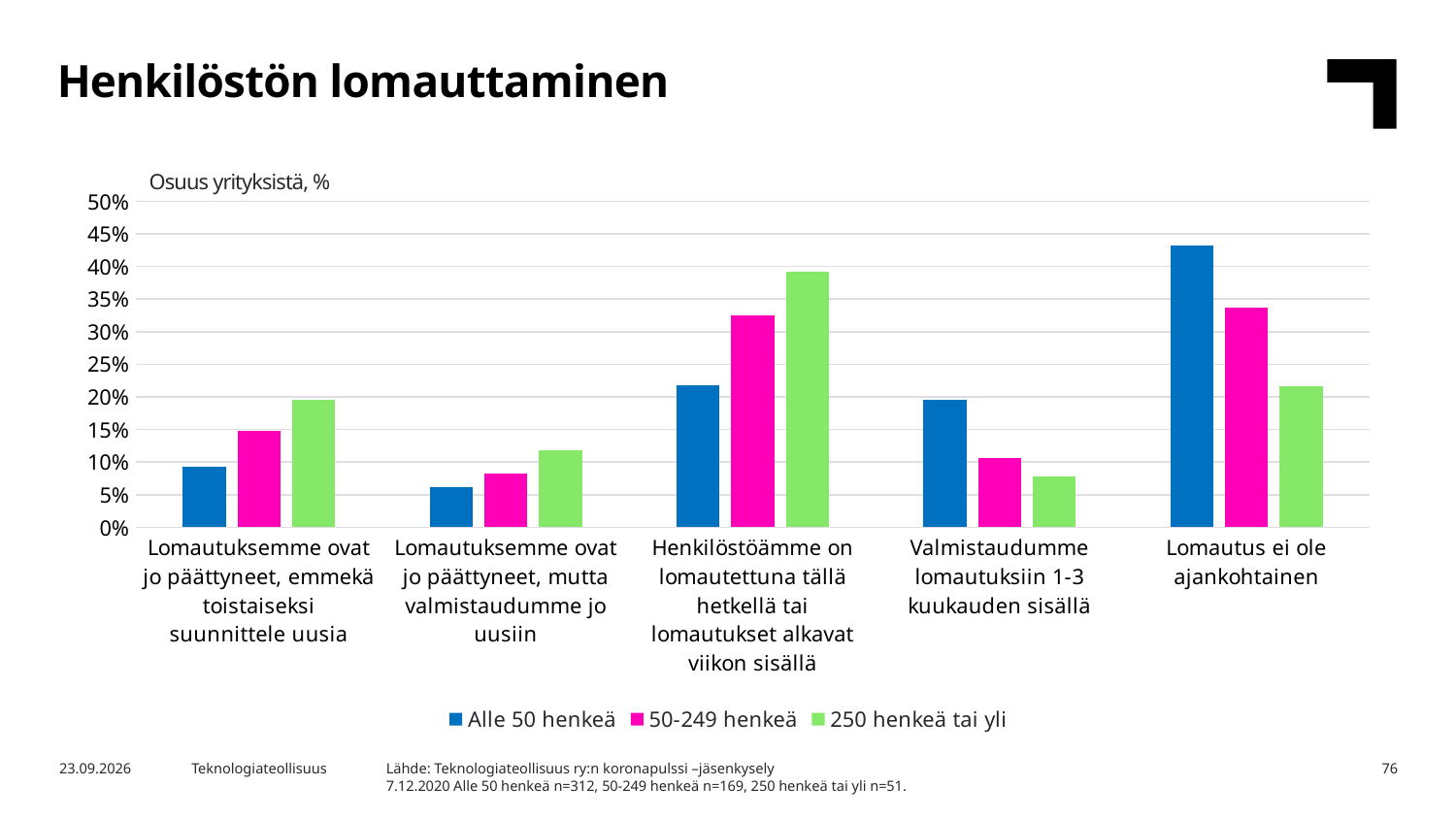
In the category 'Valmistaudumme lomautuksiin 1-3 kuukauden sisällä', which series has the larger value: 'Alle 50 henkeä' or '250 henkeä tai yli'? Alle 50 henkeä How many categories are shown on the x axis? 5 Is the value for 'Alle 50 henkeä' in the category 'Lomautus ei ole ajankohtainen' greater or less than 40%? greater In the category 'Lomautuksemme ovat jo päättyneet, emmekä toistaiseksi suunnittele uusia', which series has the larger value: 'Alle 50 henkeä' or '250 henkeä tai yli'? 250 henkeä tai yli How many series does the legend list? 3 What kind of chart is shown on the slide? Bar chart For the series '250 henkeä tai yli', which category has the highest value? Henkilöstöämme on lomautettuna tällä hetkellä tai lomautukset alkavat viikon sisällä For the series 'Alle 50 henkeä', which category has the highest value? Lomautus ei ole ajankohtainen For the series 'Alle 50 henkeä', which category has the lowest value? Lomautuksemme ovat jo päättyneet, mutta valmistaudumme jo uusiin Is the value for '250 henkeä tai yli' in the category 'Henkilöstöämme on lomautettuna tällä hetkellä tai lomautukset alkavat viikon sisällä' greater or less than 35%? greater What label is shown above the vertical axis of the chart? Osuus yrityksistä, % Is the value for '50-249 henkeä' in the category 'Lomautuksemme ovat jo päättyneet, mutta valmistaudumme jo uusiin' greater or less than 10%? less